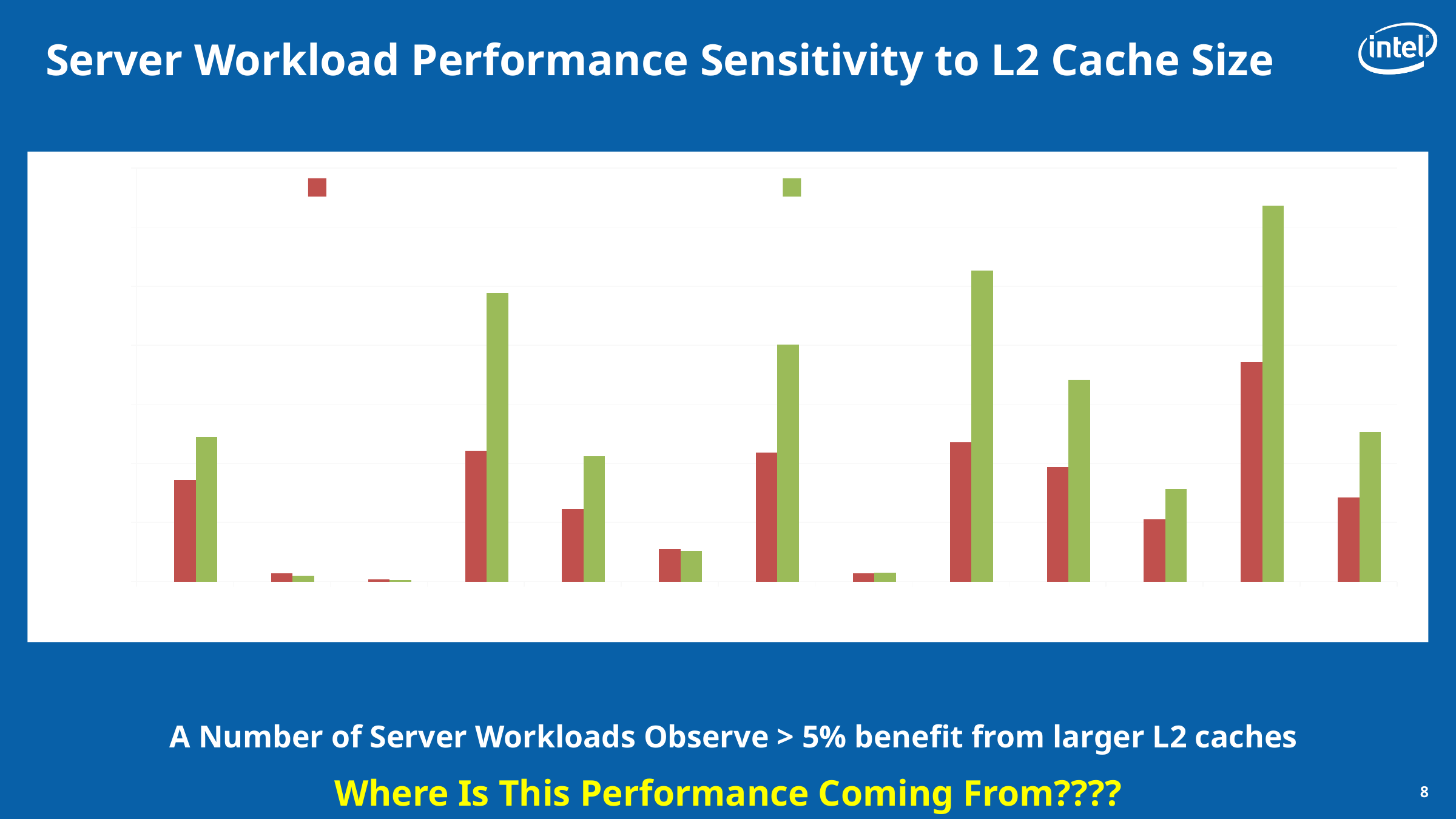
What kind of chart is shown on the slide? bar chart Which series, red or green, has the taller bar in the group with the tallest bar overall? green How many series does the chart's legend show? 2 What two colours are used for the bar series in the chart? red and green How many groups of bars are plotted in the chart? 13 Which series, red or green, reaches the highest value anywhere in the chart? green